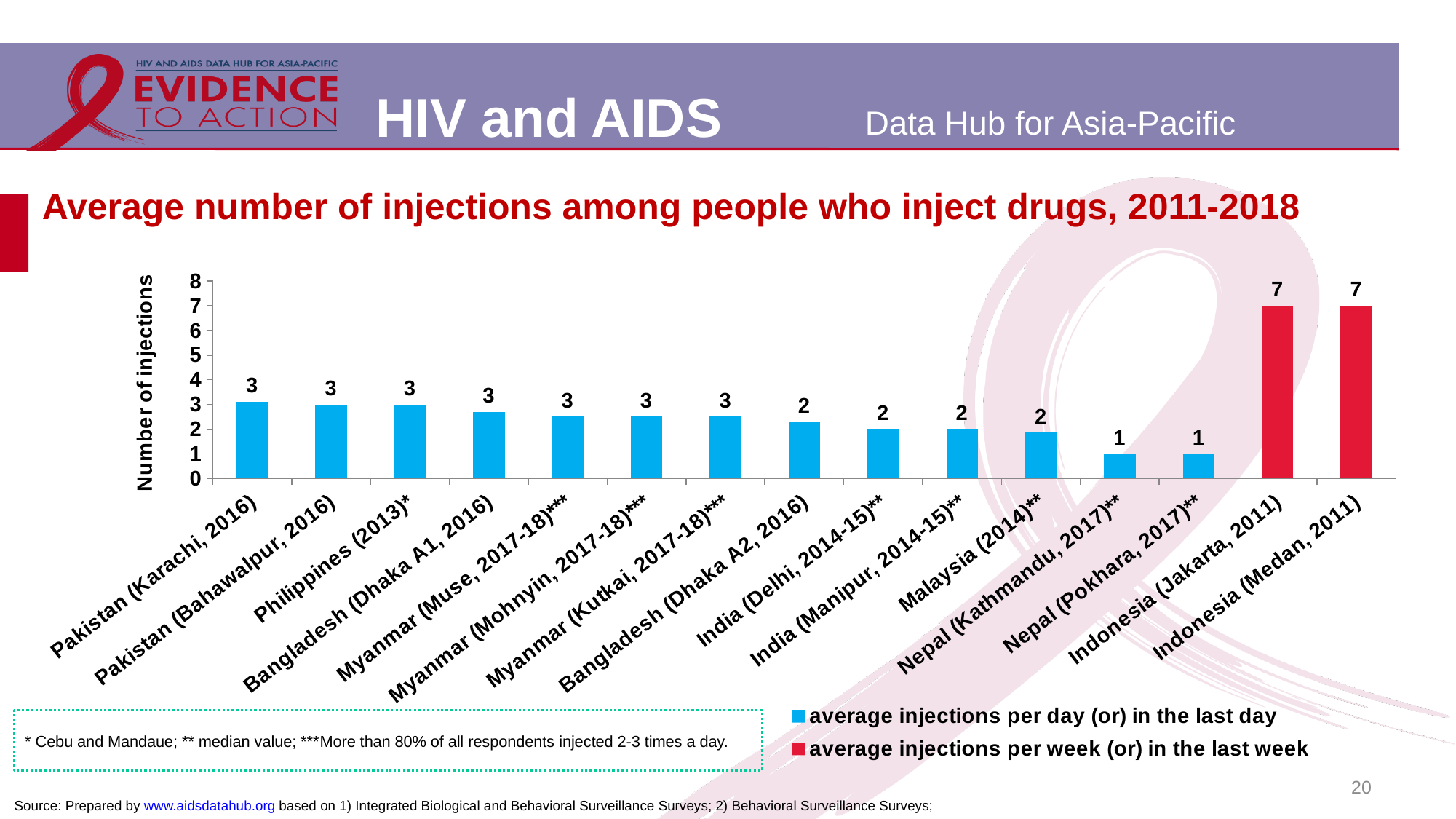
What is the value for Pakistan (Karachi, 2016)? 3 How many series does the legend list? 2 How many categories are shown on the x axis? 15 What is the value for Indonesia (Jakarta, 2011)? 7 What kind of chart is shown on the slide? bar chart What is the value for India (Delhi, 2014-15)**? 2 Is the value for Indonesia (Jakarta, 2011) greater or less than 5? greater What is the highest value shown on the chart? 7 What is the value for Nepal (Pokhara, 2017)**? 1 Which has a larger value, Philippines (2013)* or Malaysia (2014)**? Philippines (2013)* What is the lowest value shown on the chart? 1 What is the difference between the values for Indonesia (Medan, 2011) and Nepal (Kathmandu, 2017)**? 6